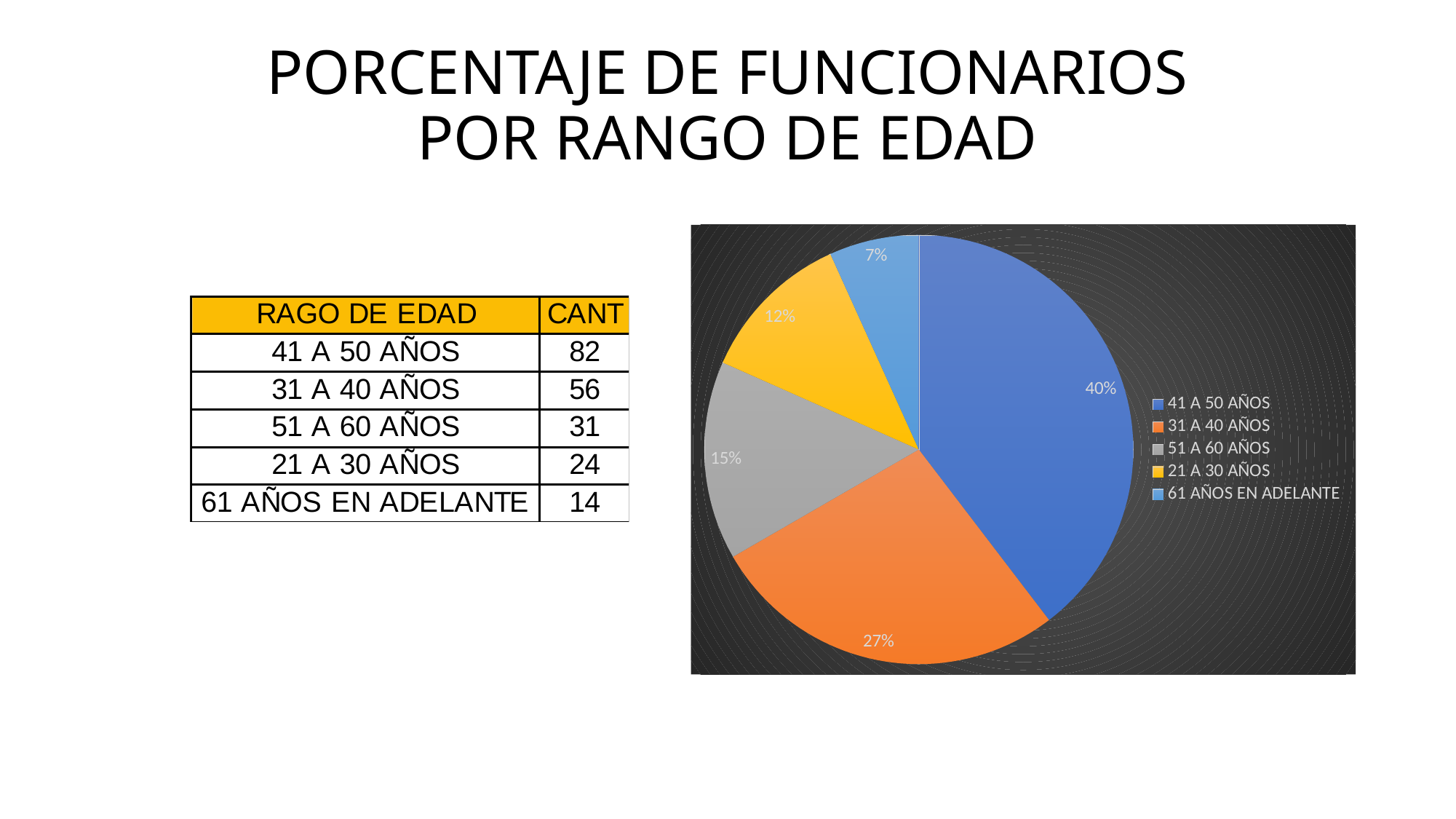
What percentage of the pie chart does the 41 A 50 AÑOS slice represent? 40% Which age range has the smallest slice of the pie chart? 61 AÑOS EN ADELANTE What percentage is shown for the 31 A 40 AÑOS slice? 27% What is the difference in percentage points between the 41 A 50 AÑOS slice and the 31 A 40 AÑOS slice? 13 What kind of chart is shown on the slide? pie chart What percentage is shown for the 61 AÑOS EN ADELANTE slice? 7% What percentage is shown for the 51 A 60 AÑOS slice? 15% Which slice is larger, 51 A 60 AÑOS or 21 A 30 AÑOS? 51 A 60 AÑOS What colour is the 21 A 30 AÑOS slice in the pie chart? yellow What percentage is shown for the 21 A 30 AÑOS slice? 12% Which age range has the largest slice of the pie chart? 41 A 50 AÑOS How many slices does the pie chart have? 5